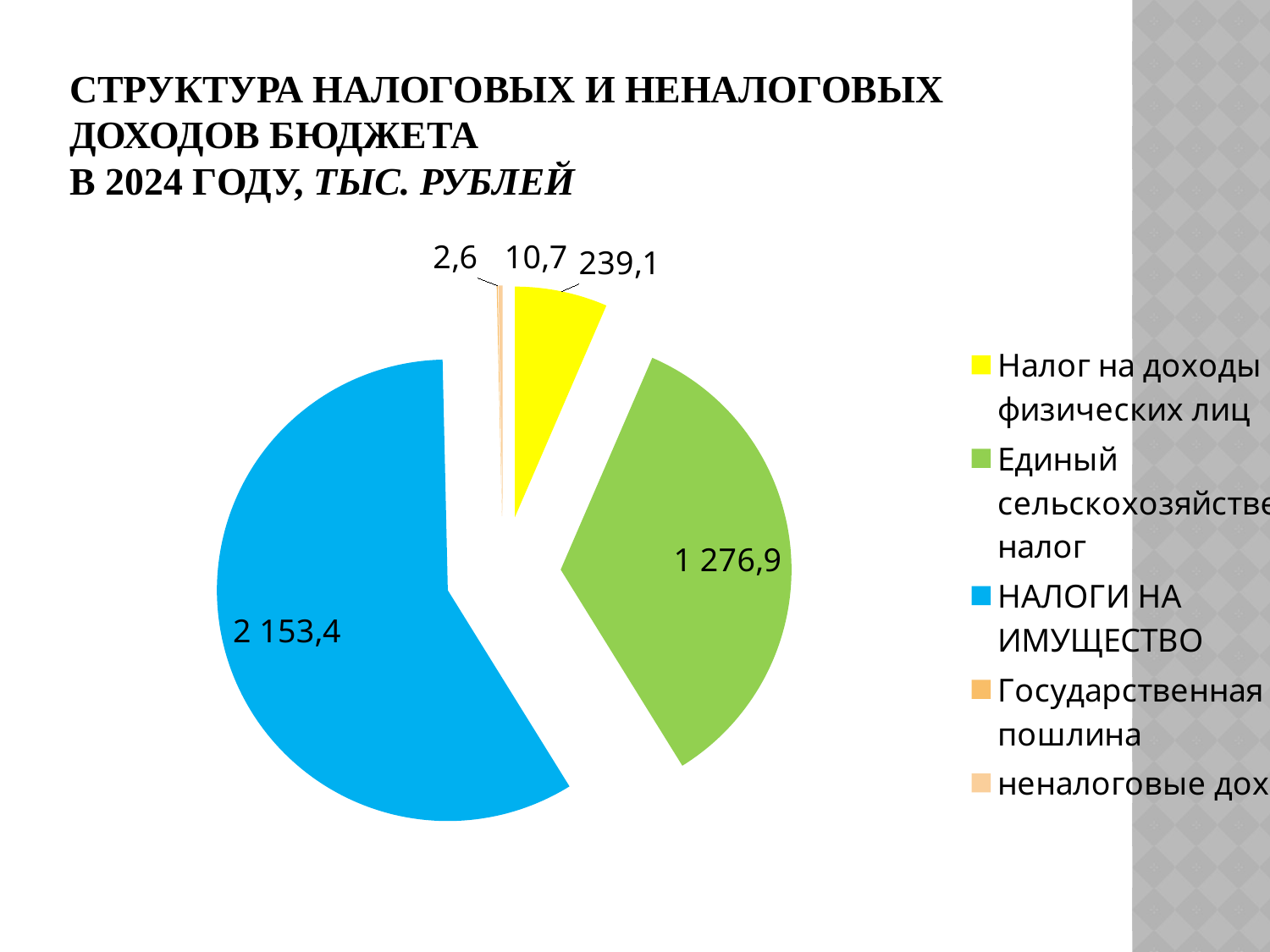
Which category has the largest slice of the pie? НАЛОГИ НА ИМУЩЕСТВО What is the smallest value labelled on the pie chart? 2,6 What is the difference between the values for НАЛОГИ НА ИМУЩЕСТВО and Единый сельскохозяйственный налог? 876,5 What is the value for Единый сельскохозяйственный налог? 1 276,9 What colour is the slice for НАЛОГИ НА ИМУЩЕСТВО? Blue Which is larger: Единый сельскохозяйственный налог or Налог на доходы физических лиц? Единый сельскохозяйственный налог How many entries does the legend list? 5 What is the difference between the values for Единый сельскохозяйственный налог and Налог на доходы физических лиц? 1 037,8 What kind of chart is shown on the slide? Pie chart What is the value for НАЛОГИ НА ИМУЩЕСТВО? 2 153,4 How many slices does the pie chart have? 5 What is the value for Налог на доходы физических лиц? 239,1